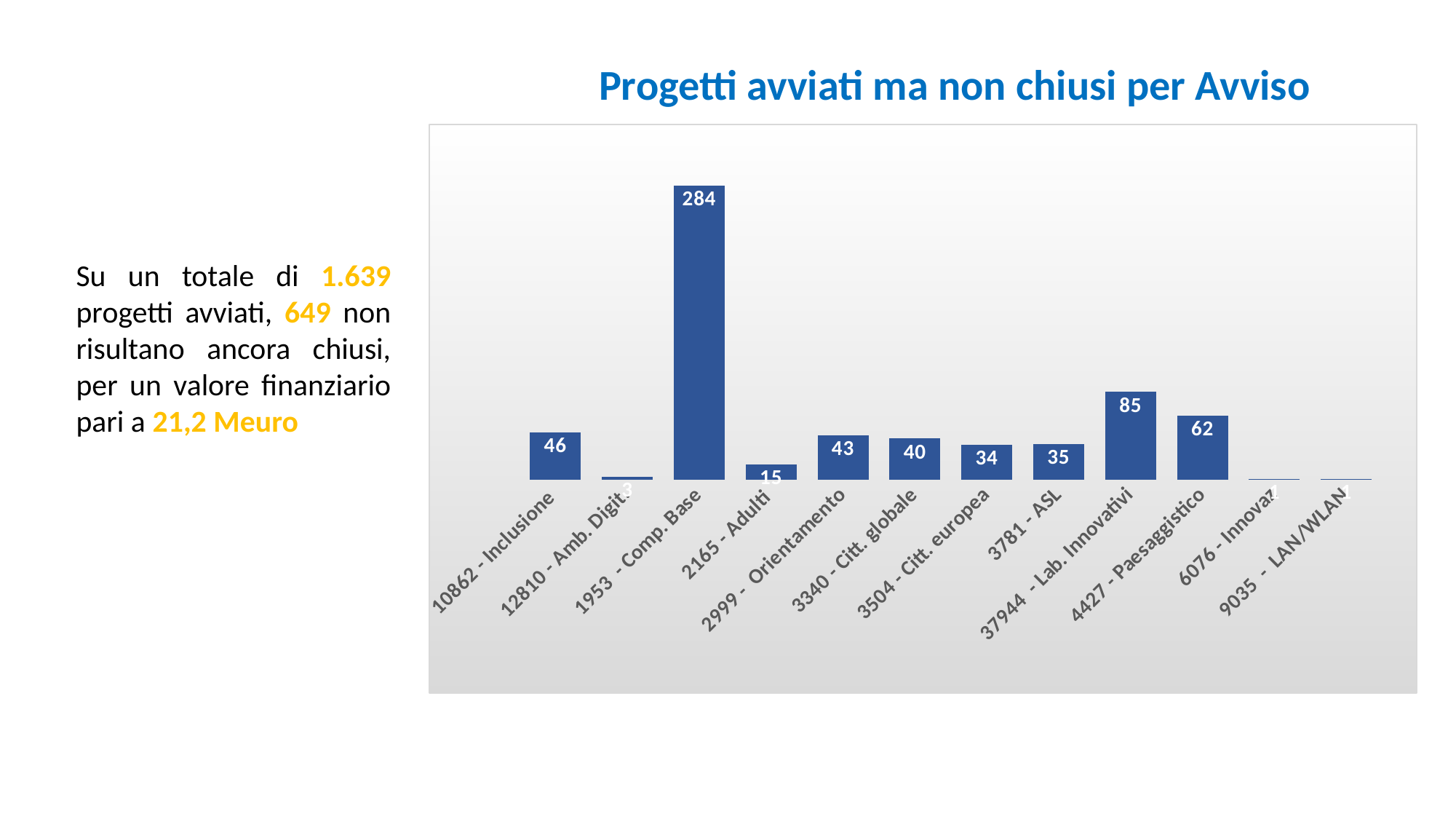
What is the value for 1953 - Comp. Base? 284 What is the title of the chart? Progetti avviati ma non chiusi per Avviso What is the value for 12810 - Amb. Digit.? 3 What is the value for 10862 - Inclusione? 46 What is the value for 37944 - Lab. Innovativi? 85 How many categories are shown in the chart? 12 What kind of chart is shown on the slide? Bar chart What is the difference between the values for 4427 - Paesaggistico and 3504 - Citt. europea? 28 What is the difference between the values for 37944 - Lab. Innovativi and 3781 - ASL? 50 Which category has the highest value? 1953 - Comp. Base Which is larger, the value for 2999 - Orientamento or the value for 3340 - Citt. globale? 2999 - Orientamento What is the value for 2165 - Adulti? 15